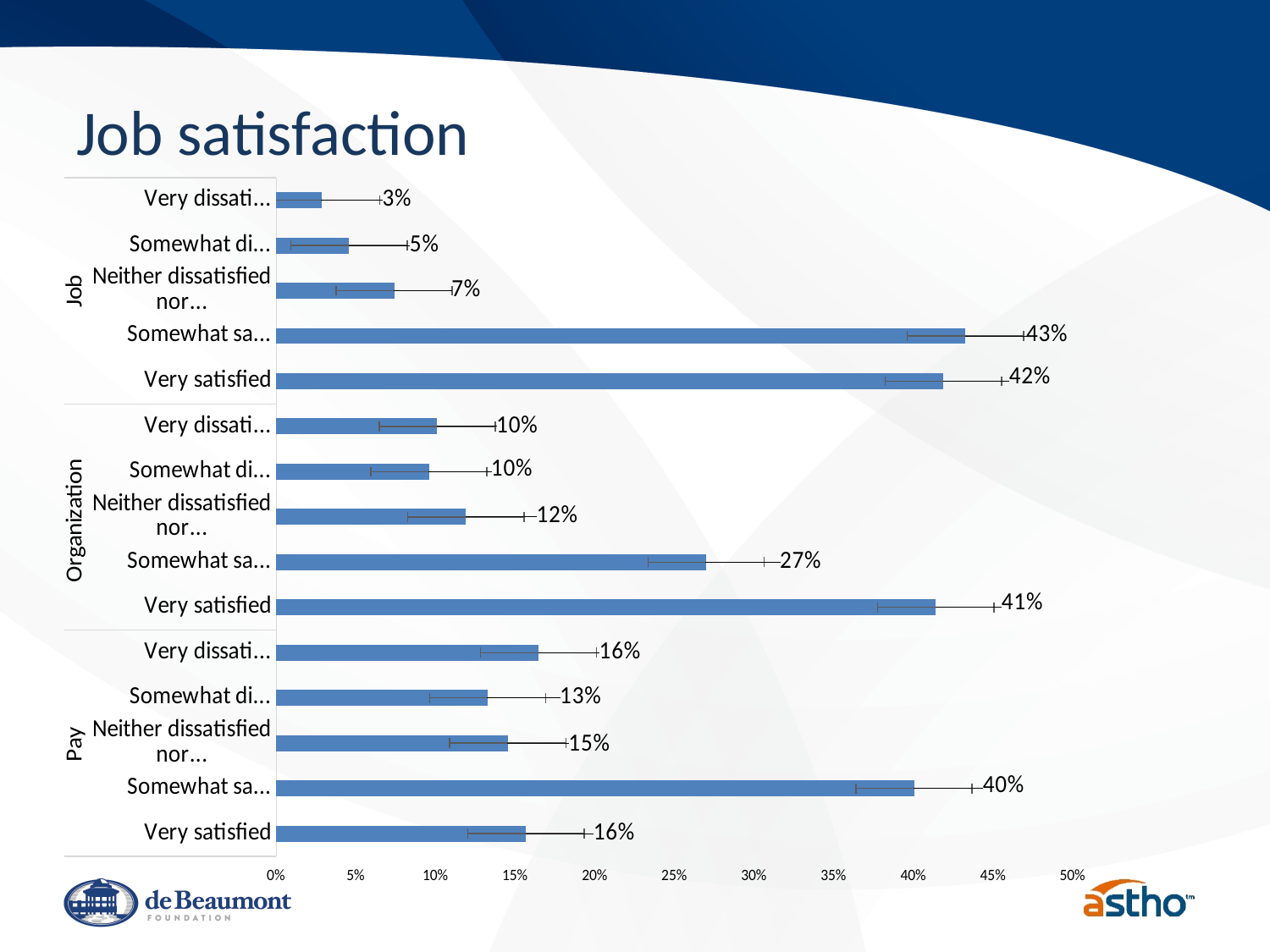
Is the value for "Very satisfied" in the Pay group greater or less than 20%? less Which is larger: the "Very satisfied" value for Organization or for Pay? Organization What is the difference between the "Neither dissatisfied nor..." values for the Pay group and the Job group? 8 percentage points How many bars are plotted on the chart? 15 What is the difference between the "Very satisfied" values for the Job group and the Pay group? 26 percentage points What is the value for "Very satisfied" in the Job group? 42% What is the lowest value shown on the chart? 3% What is the value for "Very satisfied" in the Organization group? 41% What is the value for "Very satisfied" in the Pay group? 16% What kind of chart is shown on the slide? Bar chart Which group (Job, Organization or Pay) has the highest value for "Very satisfied"? Job What is the value for "Neither dissatisfied nor..." in the Organization group? 12%